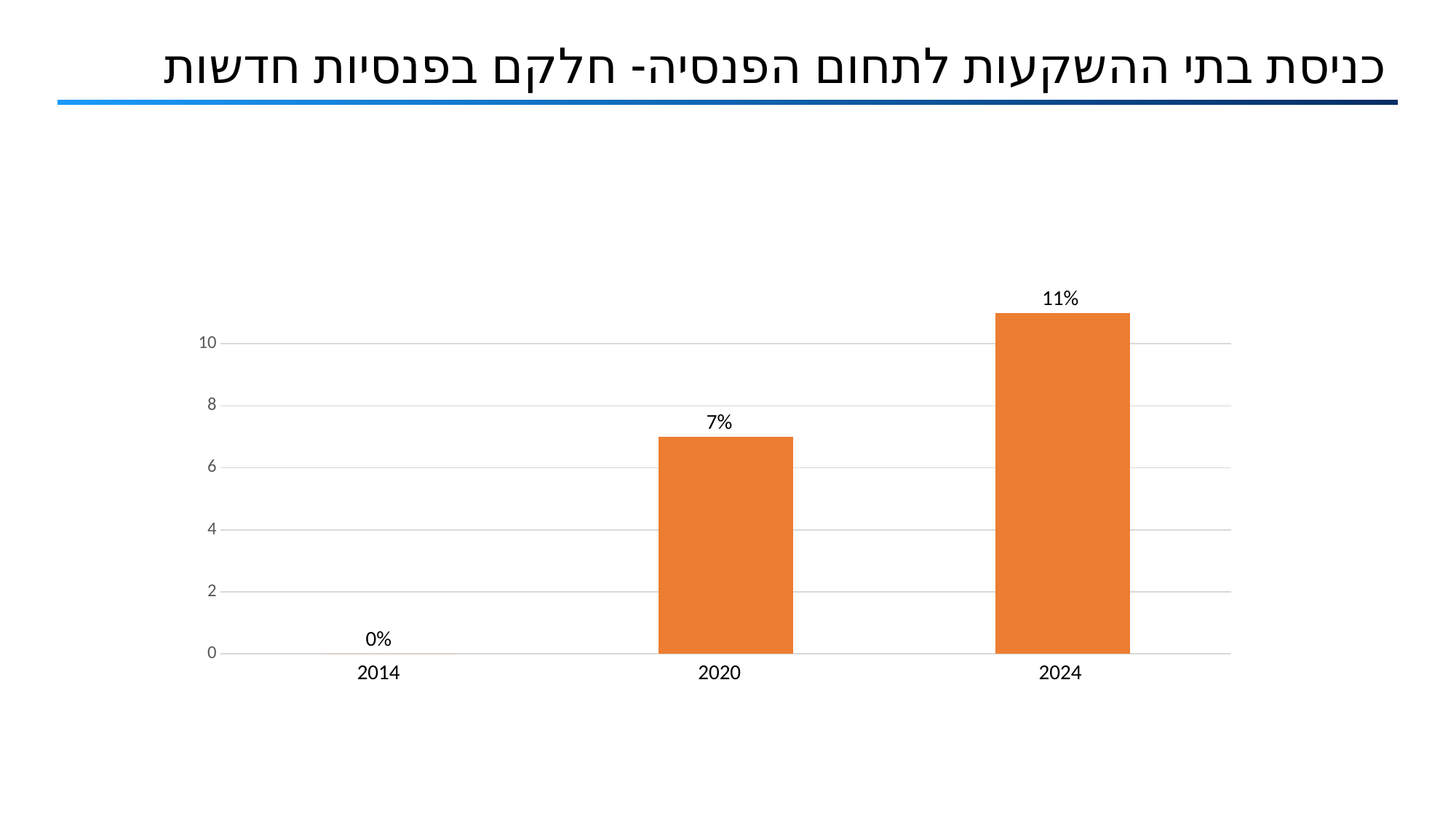
Do the values rise or fall from 2014 to 2024? rise What colour are the bars in the chart? orange What is the value for 2020? 7% Which year has the highest value? 2024 Is the value for 2024 greater or less than 10? greater What is the difference between the values for 2024 and 2020? 4% What is the value for 2014? 0% What kind of chart is shown on the slide? bar chart What is the value for 2024? 11% How many years are shown on the x axis? 3 Which year has the lowest value? 2014 Which is larger, the value for 2020 or the value for 2024? 2024